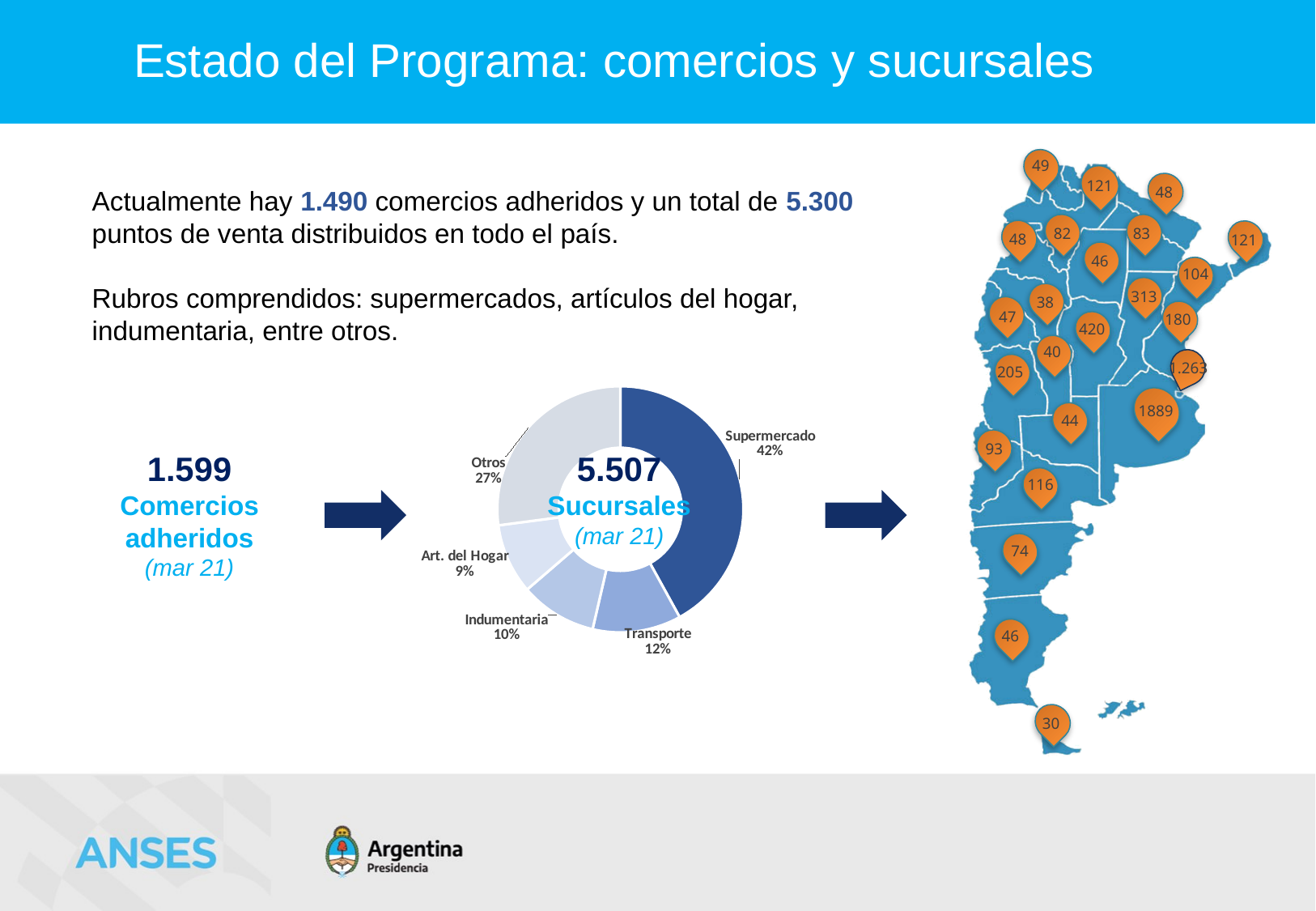
Which category has the largest share in the doughnut chart? Supermercado What percentage is shown for Indumentaria in the doughnut chart? 10% What type of chart is used to show the breakdown of Sucursales? Doughnut chart Which category has the smallest share in the doughnut chart? Art. del Hogar What percentage is shown for Otros in the doughnut chart? 27% What is the difference in percentage points between Supermercado and Otros in the doughnut chart? 15 How many categories are shown in the doughnut chart? 5 What percentage is shown for Transporte in the doughnut chart? 12% What total number of Sucursales is shown in the centre of the doughnut chart? 5.507 What share of the doughnut chart does Supermercado represent? 42% What percentage is shown for Art. del Hogar in the doughnut chart? 9% Which has a larger share in the doughnut chart, Transporte or Indumentaria? Transporte